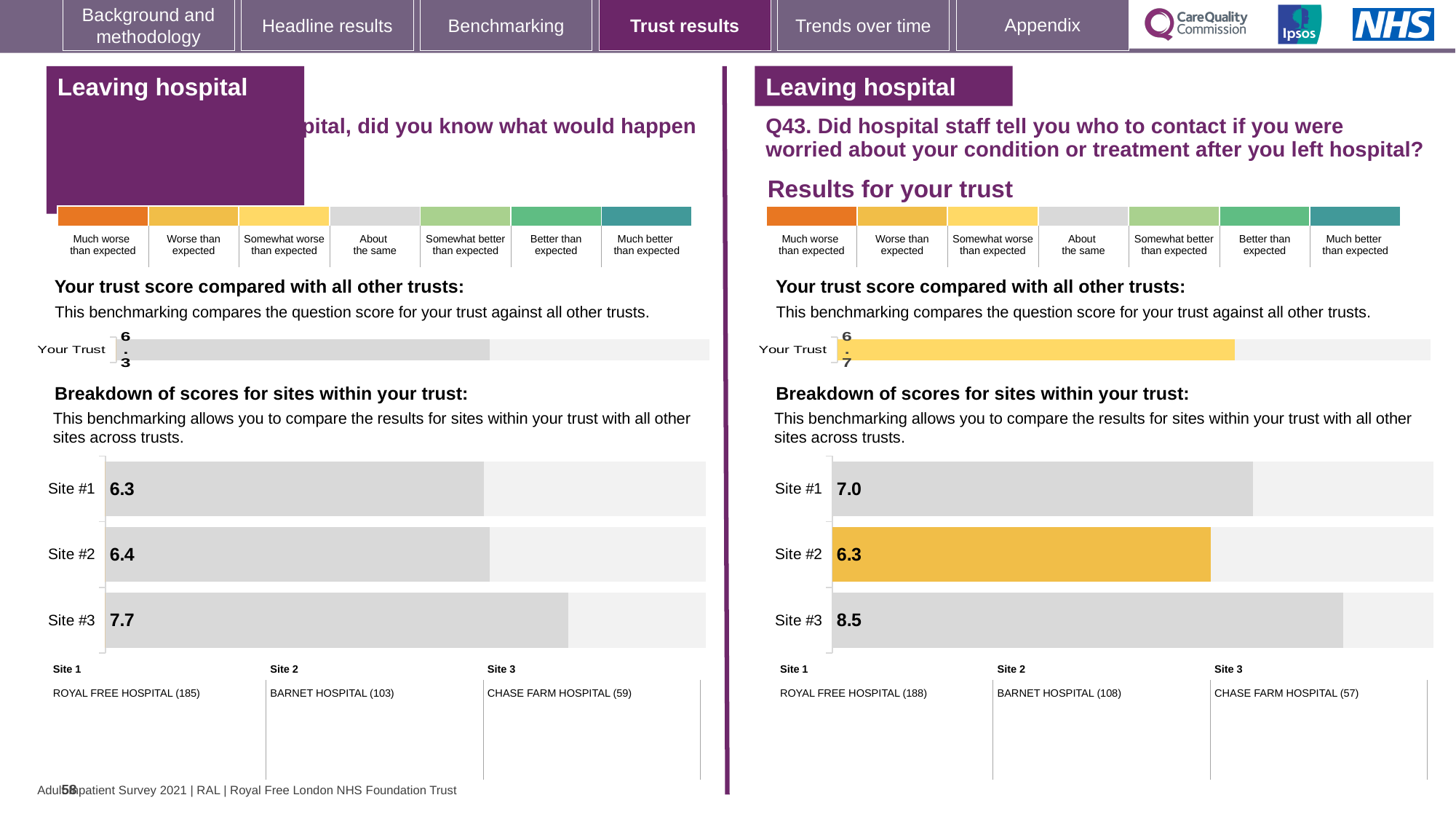
In the site breakdown chart on the left half of the slide, which site has the highest score? Site #3 In the 'Your trust score compared with all other trusts' chart on the left half of the slide, what is the score for Your Trust? 6.3 In the site breakdown chart on the left half of the slide, what is the score for Site #2? 6.4 How many sites are shown in the site breakdown chart on the left half of the slide? 3 In the site breakdown chart on the right half of the slide (Q43), which is larger: the score for Site #1 or Site #2? Site #1 In the 'Your trust score compared with all other trusts' chart on the right half of the slide (Q43), what is the score for Your Trust? 6.7 In the site breakdown chart on the right half of the slide (Q43), what is the difference between the scores for Site #3 and Site #1? 1.5 In the site breakdown chart on the right half of the slide (Q43), which site's bar is coloured yellow rather than grey? Site #2 What type of chart is used for the site breakdown on the right half of the slide (Q43)? Bar chart In the site breakdown chart on the right half of the slide (Q43), which site has the lowest score? Site #2 In the site breakdown chart on the right half of the slide (Q43), what is the score for Site #3? 8.5 In the site breakdown chart on the left half of the slide, what is the difference between the scores for Site #3 and Site #1? 1.4